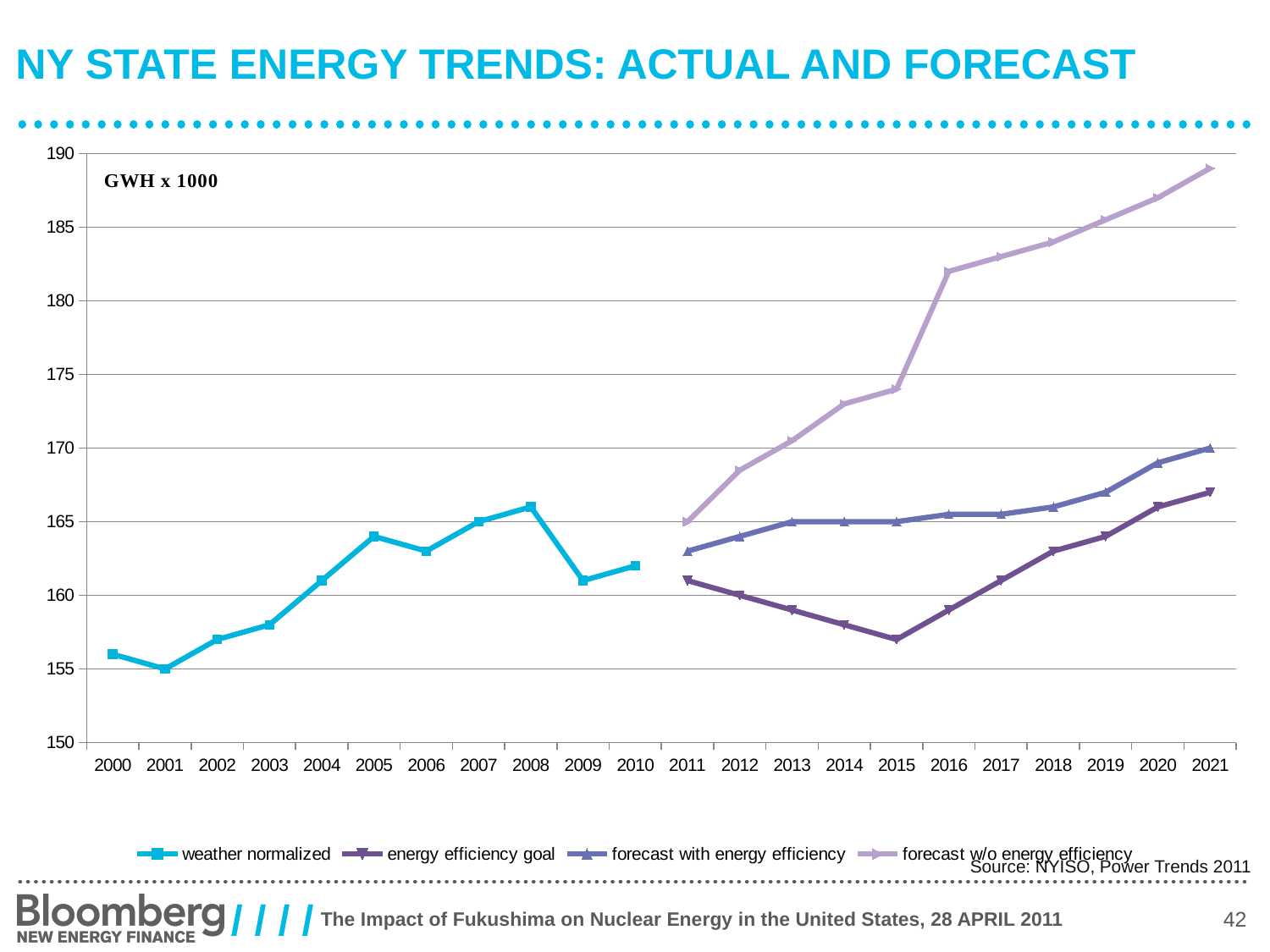
Is the forecast w/o energy efficiency value for 2016 greater or less than 180? greater Which series has the highest value in 2021? forecast w/o energy efficiency How many series does the legend list? 4 In which year does the weather normalized series reach its highest value? 2008 Is the energy efficiency goal value for 2015 greater or less than 160? less Does the forecast w/o energy efficiency series rise or fall from 2011 to 2021? rise How many years are shown on the x axis? 22 Is the forecast w/o energy efficiency value for 2021 greater or less than 185? greater What kind of chart is shown on the slide? line chart What unit label is printed in the top-left corner of the chart? GWH x 1000 In which year does the weather normalized series reach its lowest value? 2001